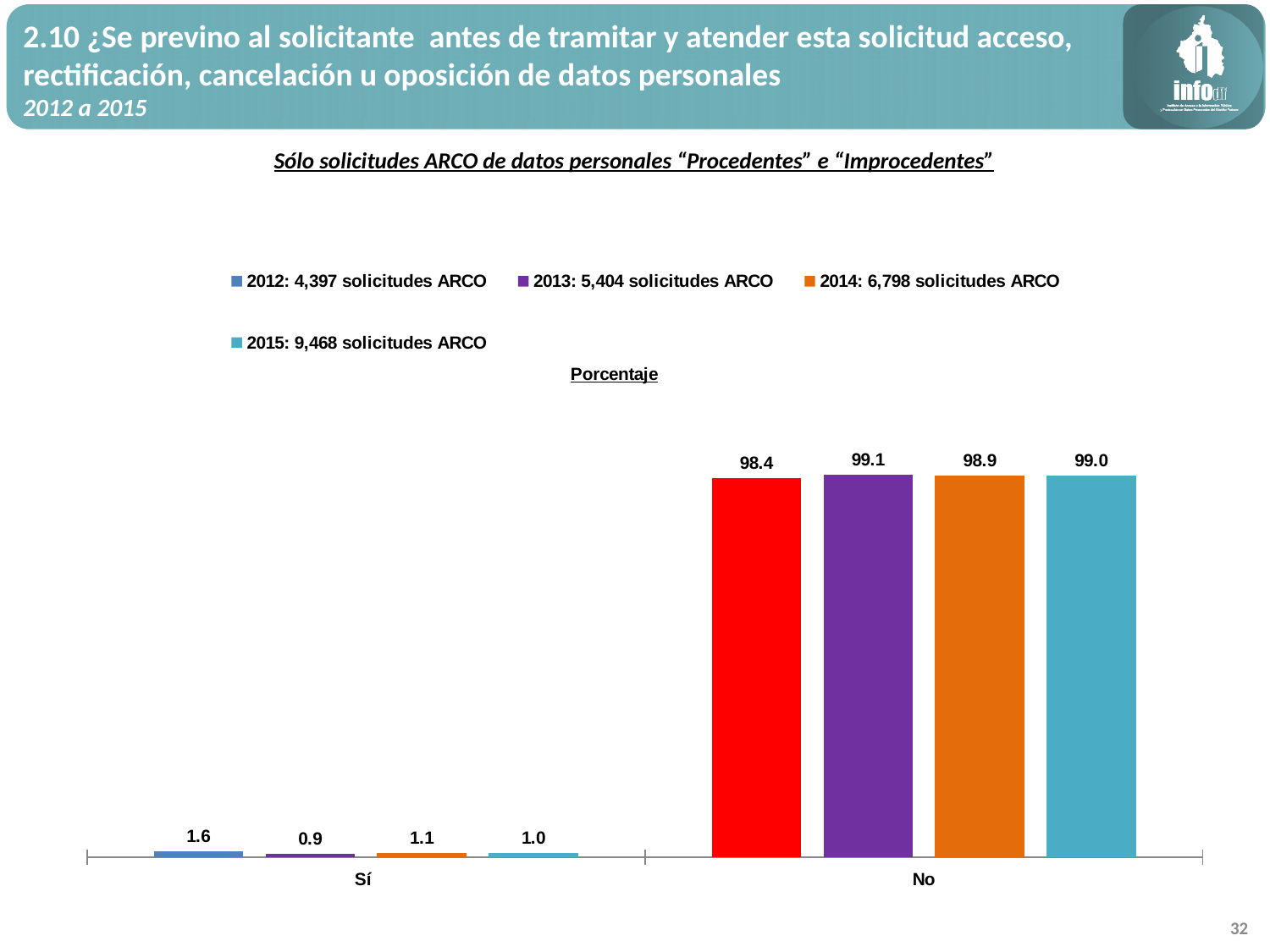
How many categories are shown on the x axis? 2 Which is larger: the 2014 value for "No" or the 2015 value for "No"? 2015 What is the value for 2013 in the "No" category? 99.1 What is the difference between the 2013 and 2012 values in the "No" category? 0.7 What is the value for 2014 in the "Sí" category? 1.1 What is the value for 2015 in the "No" category? 99.0 Which year has the highest value in the "Sí" category? 2012 How many series does the legend list? 4 What kind of chart is shown on the slide? bar chart According to the legend, how many solicitudes ARCO were there in 2015? 9,468 Which year has the lowest value in the "Sí" category? 2013 What is the value for 2012 in the "Sí" category? 1.6